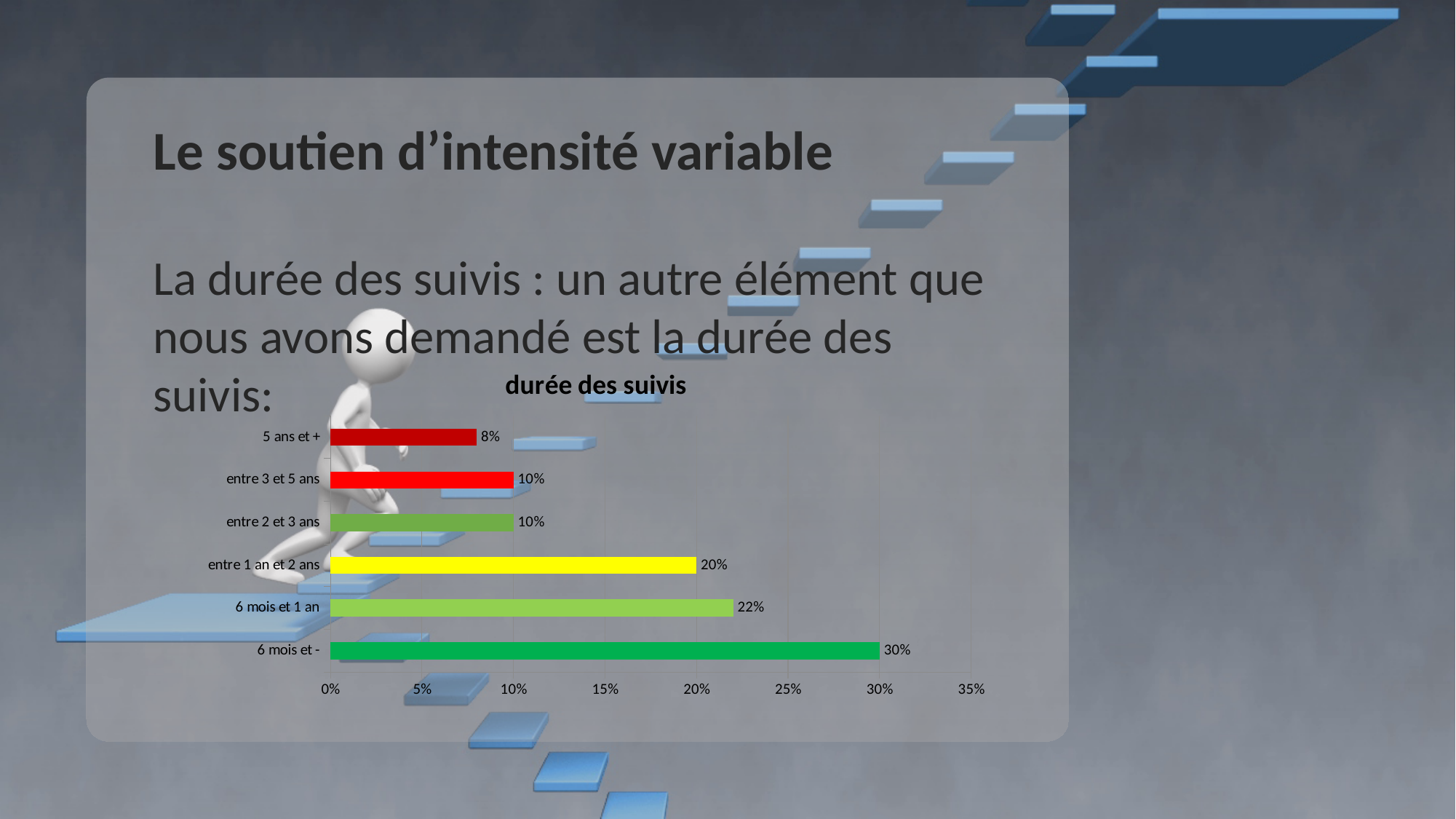
What is the value for "entre 1 an et 2 ans"? 20% What is the value for "6 mois et -"? 30% How many categories are shown in the chart? 6 Is the value for "6 mois et 1 an" greater or less than 25%? less Which category has the highest value? 6 mois et - What is the title of the chart? durée des suivis What kind of chart is shown on the slide? bar chart Which is larger, the value for "entre 1 an et 2 ans" or the value for "entre 3 et 5 ans"? entre 1 an et 2 ans What is the value for "5 ans et +"? 8% What is the difference between the values for "6 mois et -" and "6 mois et 1 an"? 8% Which category has the lowest value? 5 ans et + What is the value for "6 mois et 1 an"? 22%